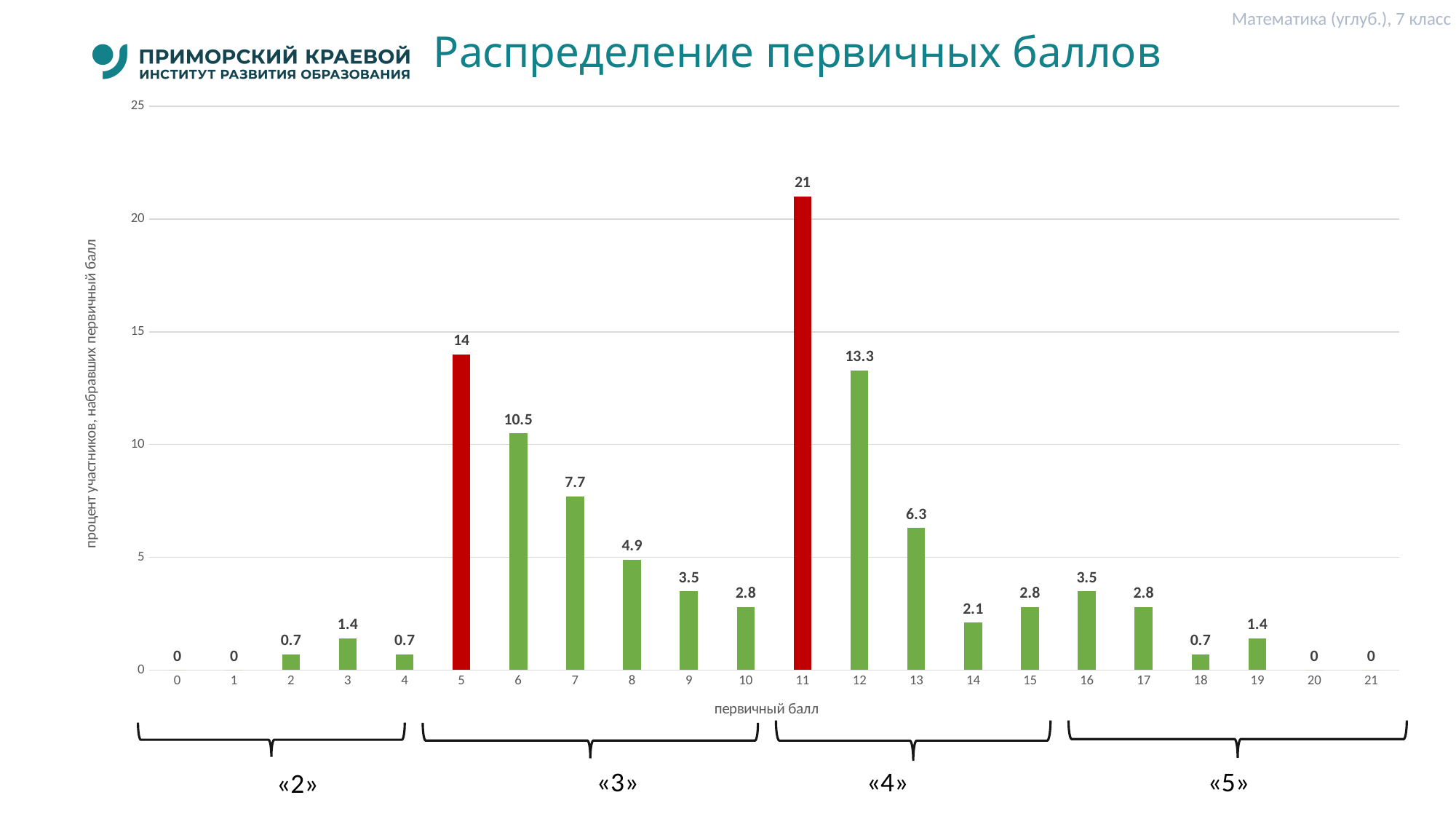
What is the value for primary score 12? 13.3 Is the value for primary score 11 greater or less than 20? greater What is the title of the chart? Распределение первичных баллов Which is larger, the value for primary score 12 or the value for primary score 6? 12 What is the difference between the values for primary scores 6 and 7? 2.8 Which primary score has the highest value? 11 What is the value for primary score 5? 14 What is the difference between the values for primary scores 11 and 5? 7 What kind of chart is shown on the slide? bar chart What is the value for primary score 8? 4.9 What is the value for primary score 11? 21 How many primary score categories are shown on the x axis? 22